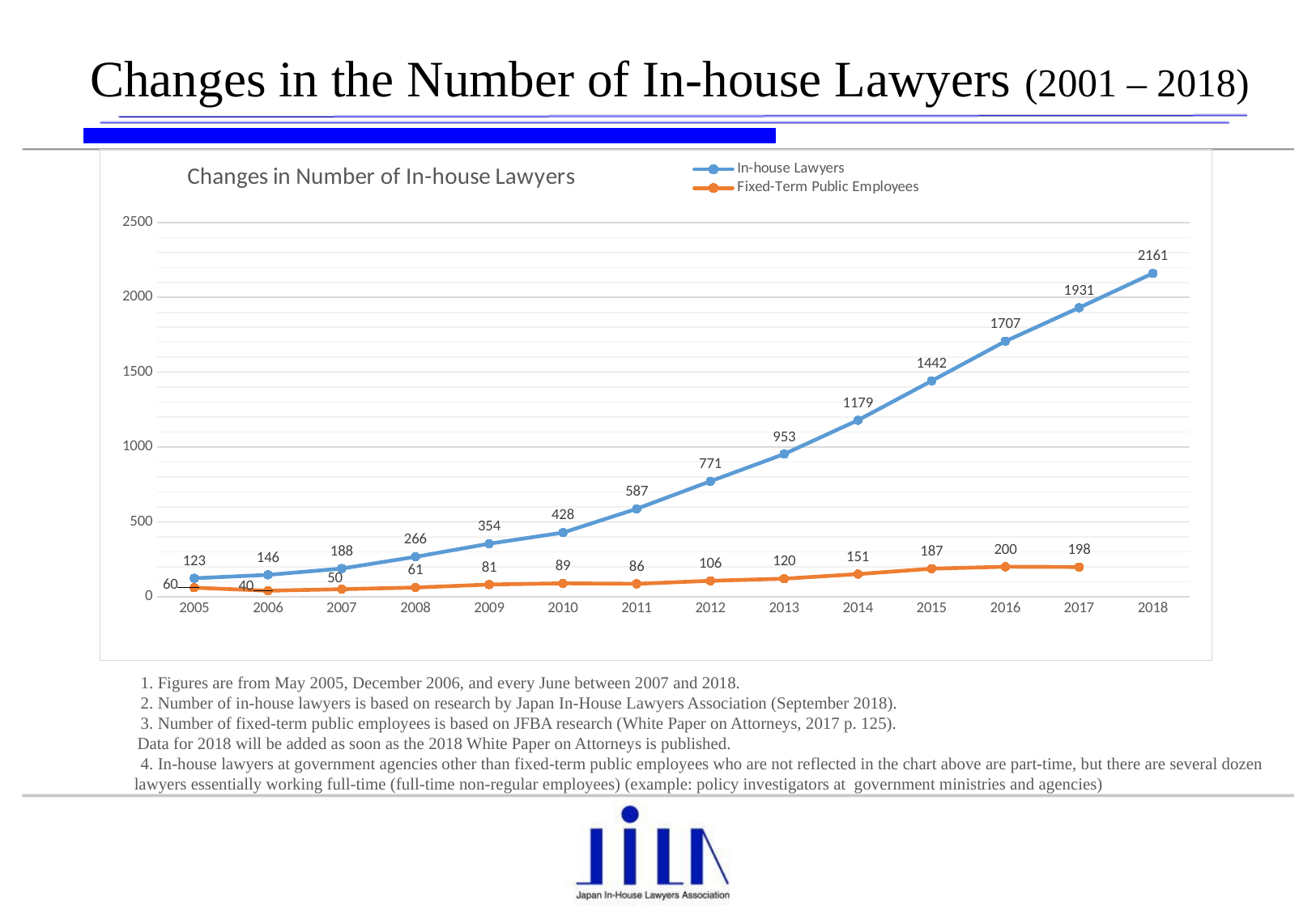
What is the difference between the In-house Lawyers values for 2018 and 2017? 230 How many series does the legend list? 2 Which is larger in 2013: In-house Lawyers or Fixed-Term Public Employees? In-house Lawyers In which year is the In-house Lawyers series at its lowest? 2005 What kind of chart is shown? Line chart What is the value for Fixed-Term Public Employees in 2016? 200 How many years are shown on the x axis? 14 In which year is the Fixed-Term Public Employees series at its highest? 2016 Is the In-house Lawyers value for 2015 greater or less than 1000? greater Does the In-house Lawyers series rise or fall from 2005 to 2018? Rise What is the number of In-house Lawyers in 2011? 587 What is the number of In-house Lawyers in 2018? 2161